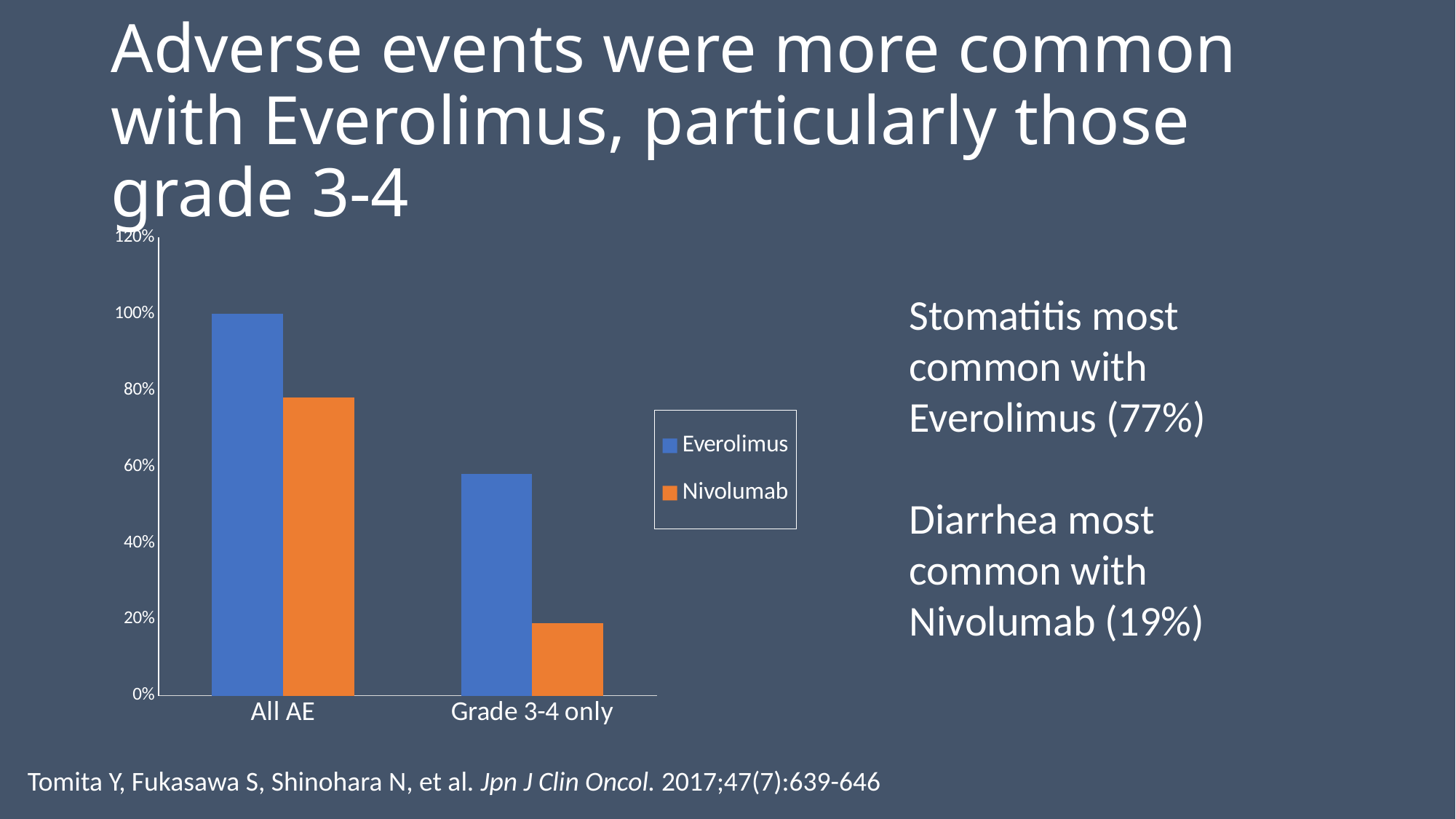
Do the values for Everolimus rise or fall from All AE to Grade 3-4 only? fall Which bar in the chart is the highest? Everolimus, All AE Is the value for Nivolumab in the All AE category greater or less than 60%? greater What kind of chart is shown on the slide? bar chart What is the value for Everolimus in the All AE category? 100% In the Grade 3-4 only category, which is larger: Everolimus or Nivolumab? Everolimus How many series does the chart's legend list? 2 In the All AE category, which is larger: Everolimus or Nivolumab? Everolimus How many categories are shown on the x axis of the chart? 2 Which bar in the chart is the lowest? Nivolumab, Grade 3-4 only What colour represents Nivolumab in the chart's legend? orange Is the value for Nivolumab in the Grade 3-4 only category greater or less than 40%? less